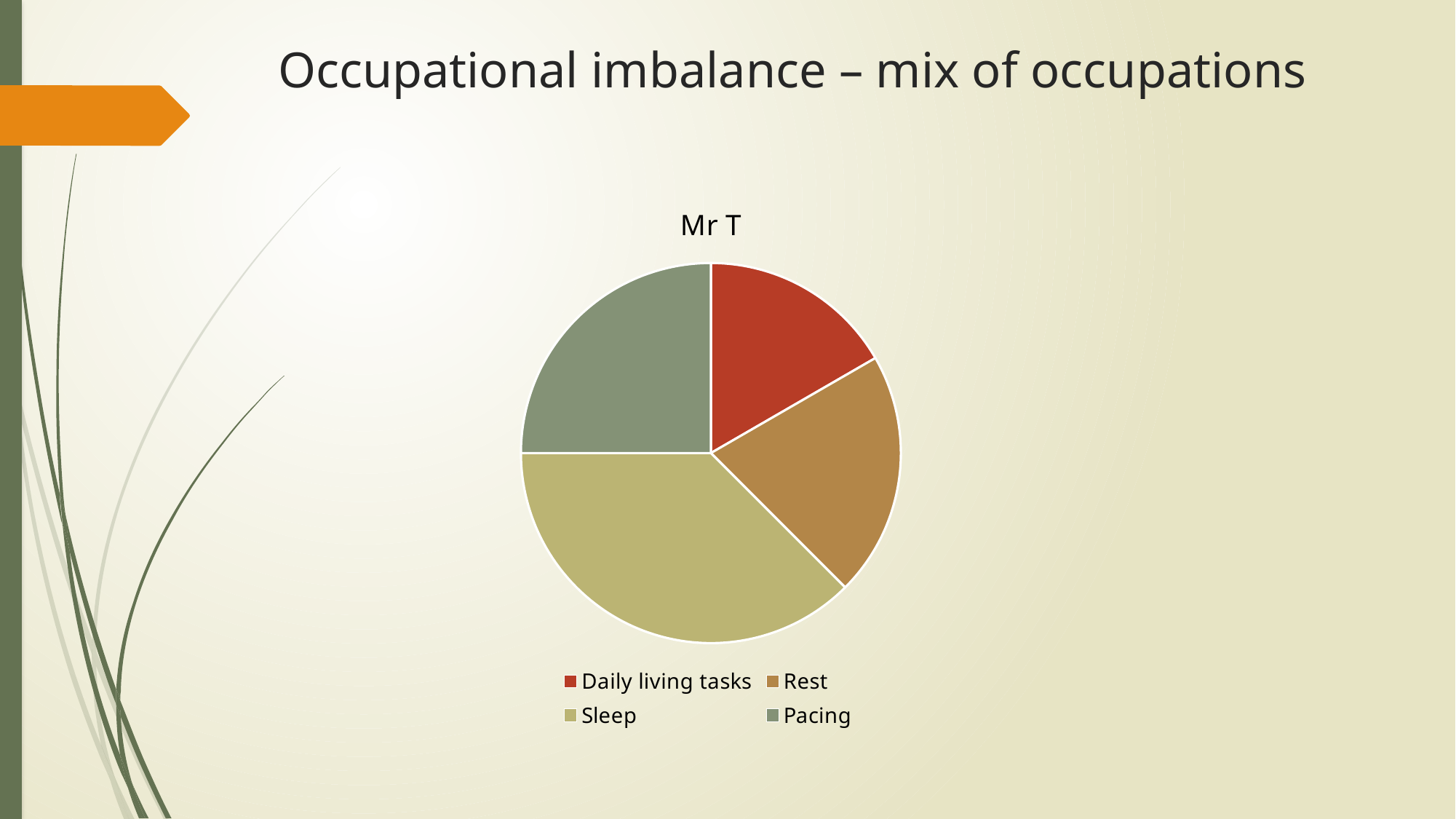
What kind of chart is shown on the slide? pie chart Which slice is larger, Sleep or Pacing? Sleep How many slices does the pie chart have? 4 Which slice is larger, Rest or Sleep? Sleep What is the title of the pie chart? Mr T How many entries does the legend list? 4 Which occupation takes up the largest share of the pie chart? Sleep Which slice is larger, Pacing or Daily living tasks? Pacing Which legend entry is shown in red? Daily living tasks Which occupation takes up the smallest share of the pie chart? Daily living tasks